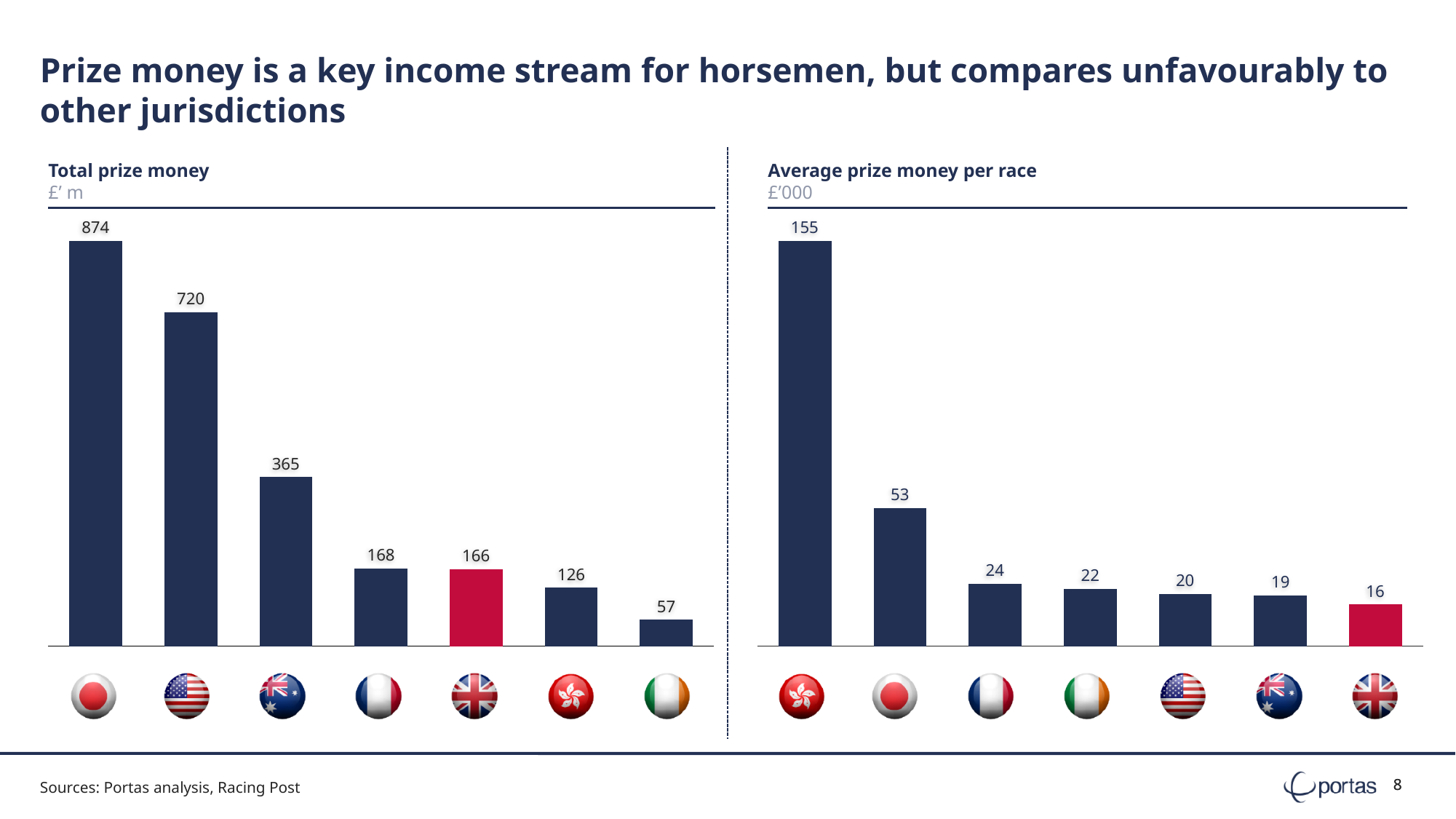
In the 'Average prize money per race' chart, what is the difference between the tallest bar (155) and the red UK bar (16)? 139 How many bars are shown in the 'Total prize money' chart? 7 In the 'Average prize money per race' chart, what is the value of the red highlighted bar (UK)? 16 What type of chart is the 'Average prize money per race' chart? Bar chart In the 'Total prize money' chart, what is the value of the first (tallest) bar, for Japan? 874 What unit is shown under the title of the 'Total prize money' chart? £' m In the 'Average prize money per race' chart, do the values rise or fall from left to right? Fall In the 'Total prize money' chart, what is the difference between the first bar (874) and the second bar (720)? 154 In the 'Average prize money per race' chart, what is the value of the tallest bar (Hong Kong)? 155 In the 'Total prize money' chart, which is larger: the France bar (168) or the red UK bar (166)? France (168) In the 'Total prize money' chart, what is the value of the lowest bar (Ireland)? 57 In the 'Total prize money' chart, what is the value of the red highlighted bar (UK)? 166